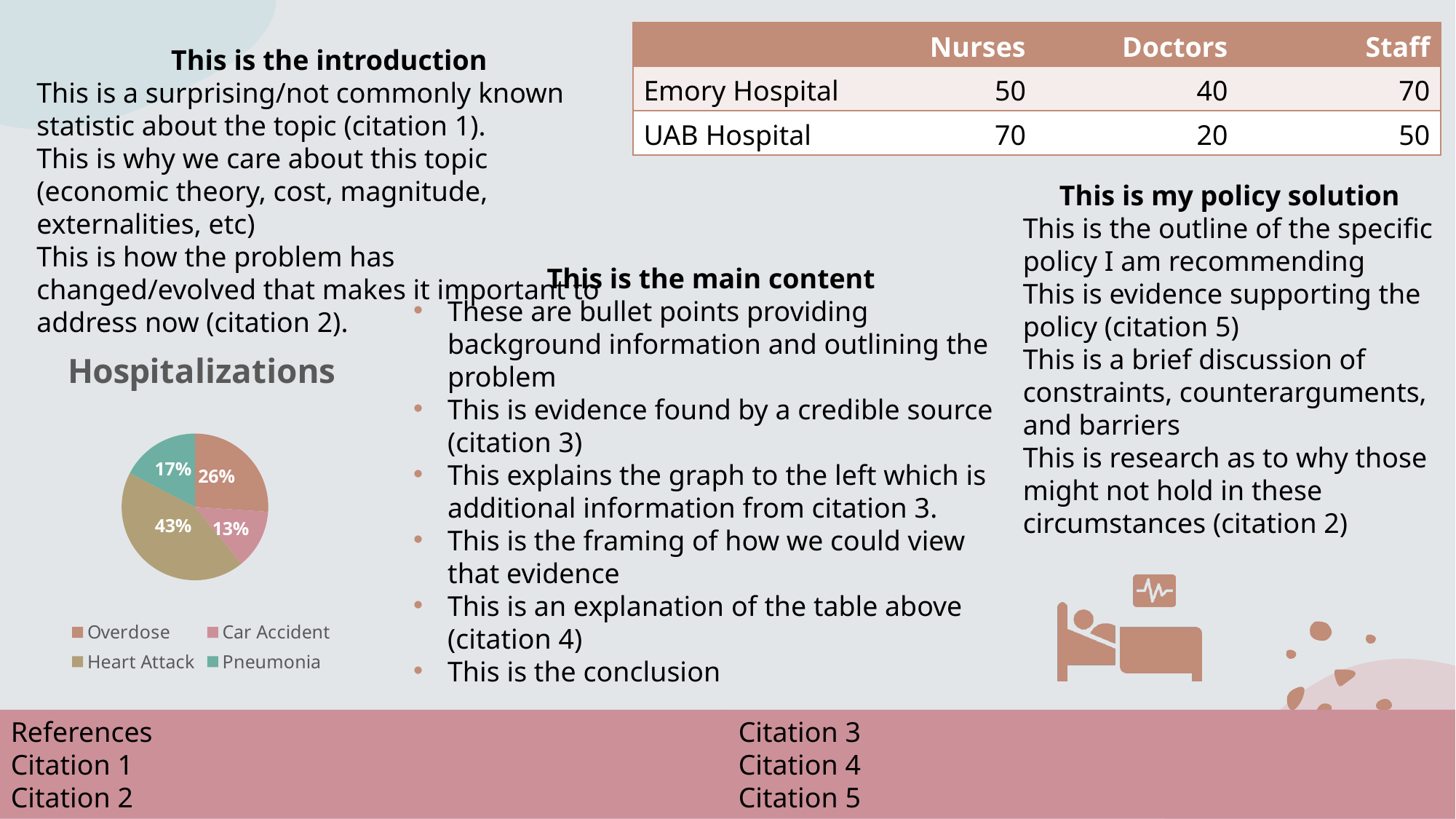
Which category has the largest slice in the Hospitalizations pie chart? Heart Attack In the Hospitalizations pie chart, what share is Car Accident? 13% How many categories are shown in the Hospitalizations pie chart? 4 In the Hospitalizations pie chart, what share is Pneumonia? 17% What kind of chart is the Hospitalizations chart? pie chart What is the title of the pie chart on the slide? Hospitalizations In the Hospitalizations pie chart, which is larger, Overdose or Pneumonia? Overdose In the Hospitalizations pie chart, what share is Heart Attack? 43% In the Hospitalizations pie chart, what share is Overdose? 26% In the Hospitalizations pie chart, what is the difference between the Heart Attack and Overdose shares? 17% Which category has the smallest slice in the Hospitalizations pie chart? Car Accident In the Hospitalizations pie chart, what is the difference between the Pneumonia and Car Accident shares? 4%